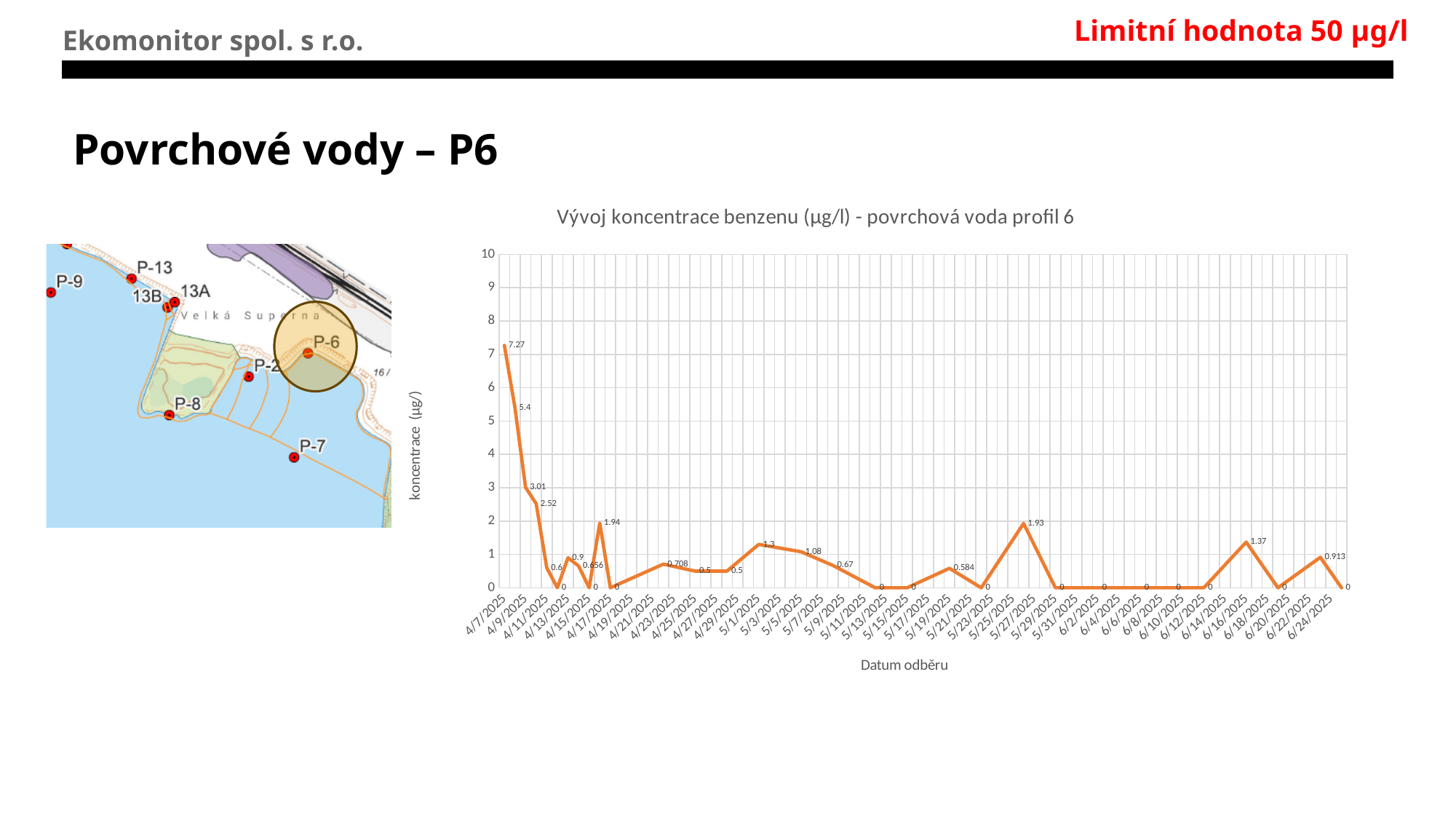
What is the concentration value for 4/7/2025, the first point on the chart? 7.27 What is the difference between the first value (7.27) and the second value (5.4) on the chart? 1.87 Do the concentration values generally rise or fall from the start of the period to the end? fall What is the label of the x axis of the chart? Datum odběru What kind of chart is shown on the slide? line chart What is the concentration value for 4/9/2025? 3.01 Is the highest value on the chart greater or less than 8? less What is the highest benzene concentration value plotted on the chart? 7.27 Which is larger, the peak labelled 1.94 in April or the peak labelled 1.93 in May? 1.94 What is the title of the chart? Vývoj koncentrace benzenu (µg/l) - povrchová voda profil 6